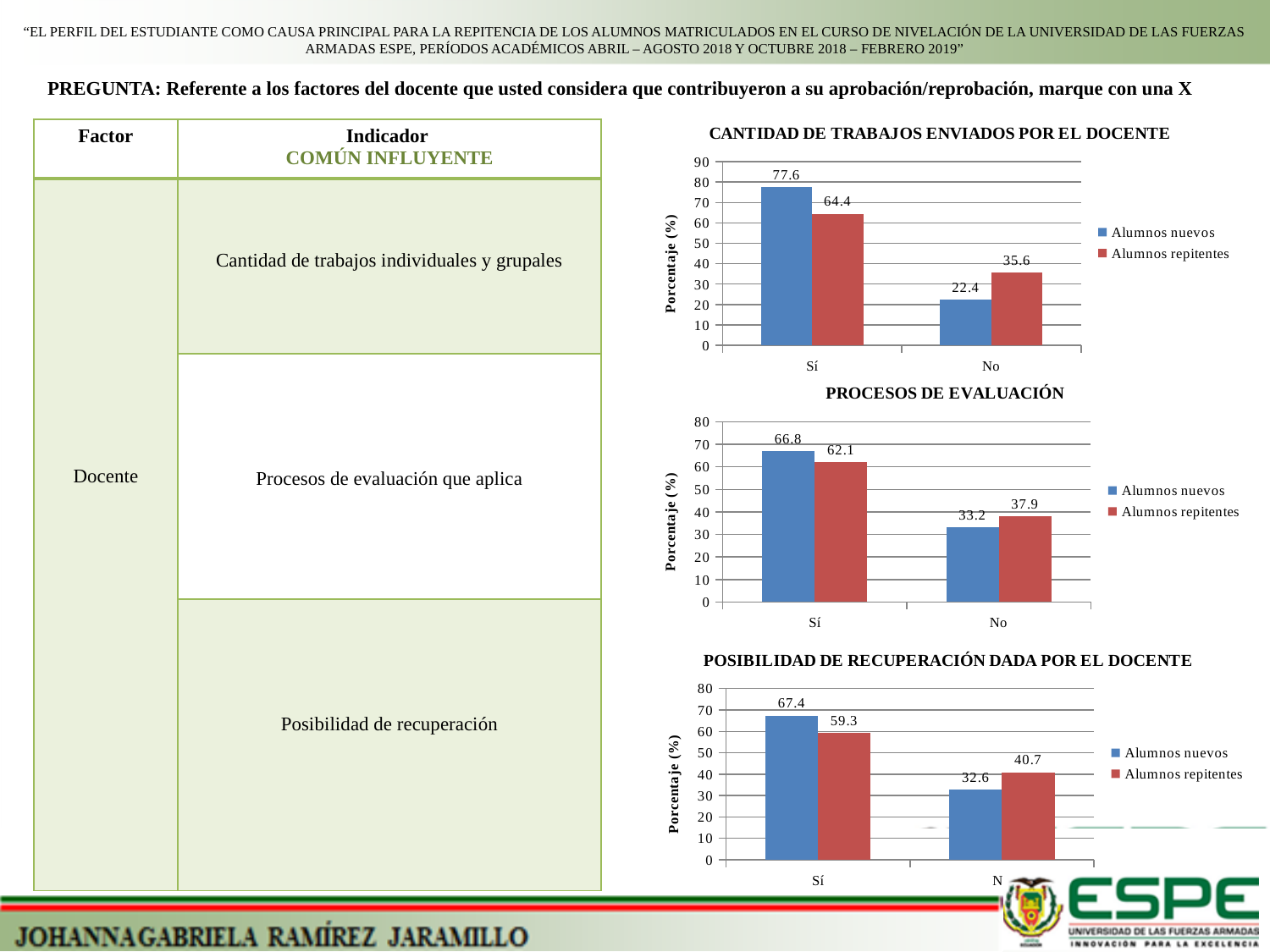
In the 'POSIBILIDAD DE RECUPERACIÓN DADA POR EL DOCENTE' chart, which bar has the lowest value? Alumnos nuevos, No (32.6) What is the y-axis label of the 'POSIBILIDAD DE RECUPERACIÓN DADA POR EL DOCENTE' chart? Porcentaje (%) How many series does the legend of the 'CANTIDAD DE TRABAJOS ENVIADOS POR EL DOCENTE' chart list? 2 In the 'PROCESOS DE EVALUACIÓN' chart, what is the difference between Alumnos repitentes and Alumnos nuevos in the No category? 4.7 In the 'PROCESOS DE EVALUACIÓN' chart, what is the value for Alumnos repitentes in the Sí category? 62.1 What kind of chart is the 'PROCESOS DE EVALUACIÓN' chart? Bar chart In the 'POSIBILIDAD DE RECUPERACIÓN DADA POR EL DOCENTE' chart, what is the value for Alumnos repitentes in the No category? 40.7 In the 'CANTIDAD DE TRABAJOS ENVIADOS POR EL DOCENTE' chart, what is the value for Alumnos repitentes in the No category? 35.6 In the 'PROCESOS DE EVALUACIÓN' chart, which series has the higher value in the No category? Alumnos repitentes In the 'CANTIDAD DE TRABAJOS ENVIADOS POR EL DOCENTE' chart, what is the difference between Alumnos nuevos and Alumnos repitentes in the Sí category? 13.2 In the 'POSIBILIDAD DE RECUPERACIÓN DADA POR EL DOCENTE' chart, what is the value for Alumnos nuevos in the Sí category? 67.4 In the 'CANTIDAD DE TRABAJOS ENVIADOS POR EL DOCENTE' chart, what is the value for Alumnos nuevos in the Sí category? 77.6